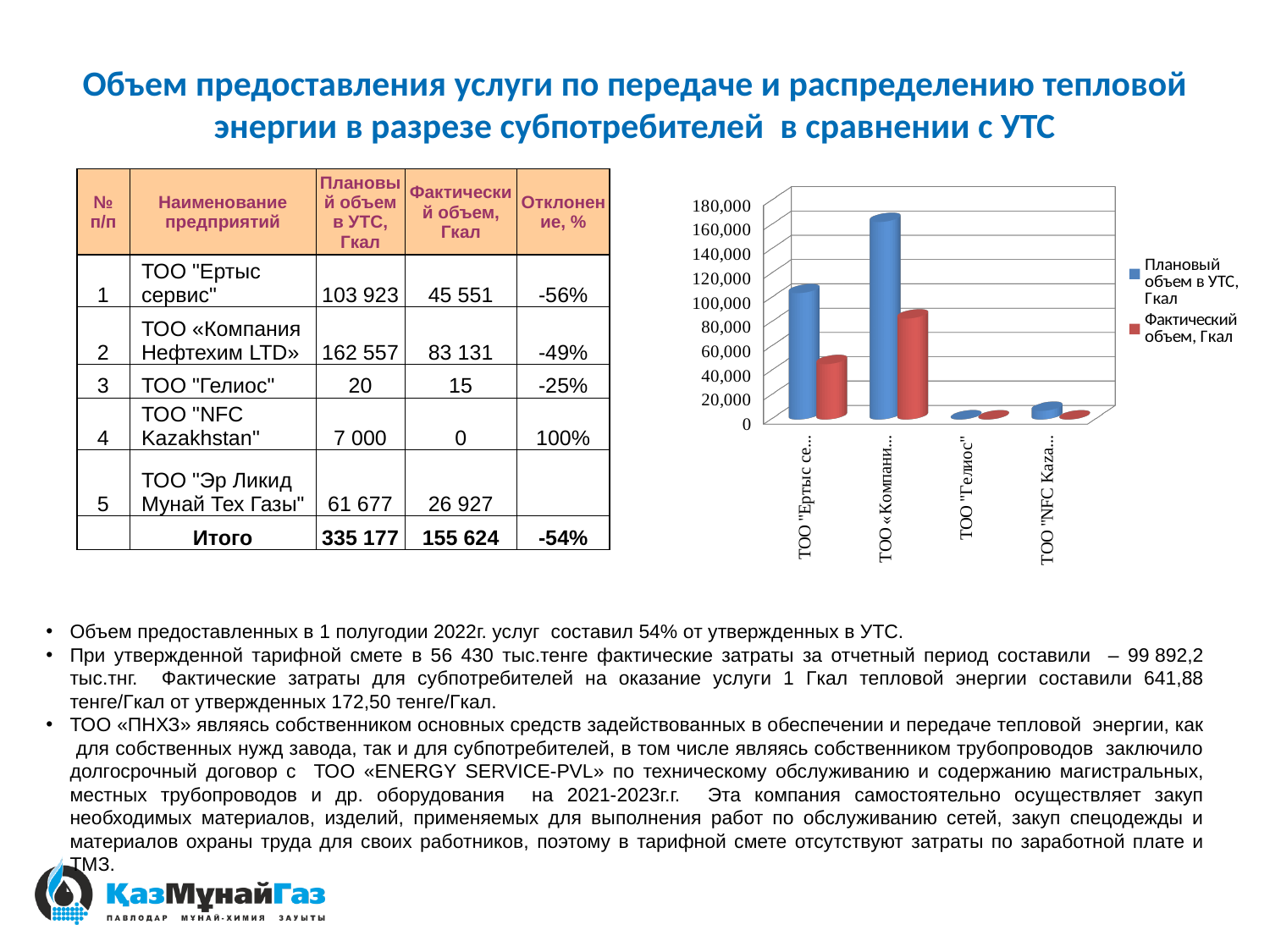
Is the value of "Плановый объем в УТС, Гкал" for ТОО «Компания Нефтехим LTD» greater or less than 140,000? greater Is the value of "Плановый объем в УТС, Гкал" for ТОО "NFC Kazakhstan" greater or less than 20,000? less Is the value of "Плановый объем в УТС, Гкал" for ТОО "Ертыс сервис" greater or less than 100,000? greater For ТОО "Ертыс сервис", which is larger on the chart: the planned volume (Плановый объем в УТС) or the actual volume (Фактический объем)? Плановый объем в УТС Which colour represents the series "Фактический объем, Гкал" on the chart? red What kind of chart is shown on the slide? bar chart How many categories (enterprises) are shown on the chart's x axis? 4 Which category has the highest value for the series "Плановый объем в УТС, Гкал"? ТОО «Компания Нефтехим LTD» How many series does the chart legend list? 2 Which is larger on the chart: the planned volume for ТОО "Ертыс сервис" or the planned volume for ТОО «Компания Нефтехим LTD»? ТОО «Компания Нефтехим LTD»